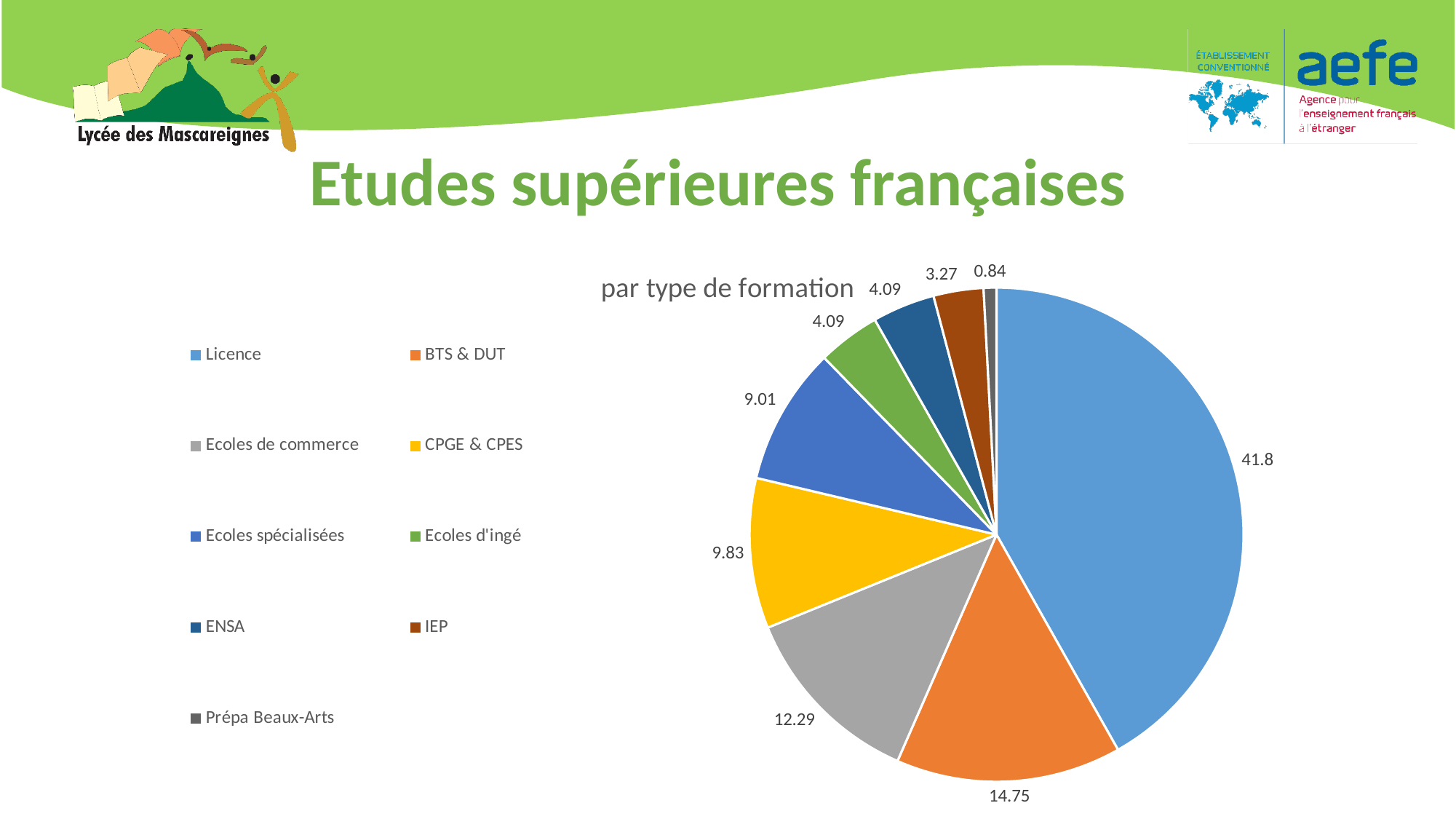
Which category has the largest slice? Licence What kind of chart is shown on the slide? pie chart What is the difference between the values for Licence and BTS & DUT? 27.05 Which is larger, Ecoles spécialisées or Ecoles de commerce? Ecoles de commerce How many categories does the pie chart have? 9 What is the value for CPGE & CPES? 9.83 What is the value for Ecoles de commerce? 12.29 What is the value for Licence? 41.8 Which category has the smallest slice? Prépa Beaux-Arts What is the value for IEP? 3.27 What is the title of the chart? par type de formation What is the value for BTS & DUT? 14.75